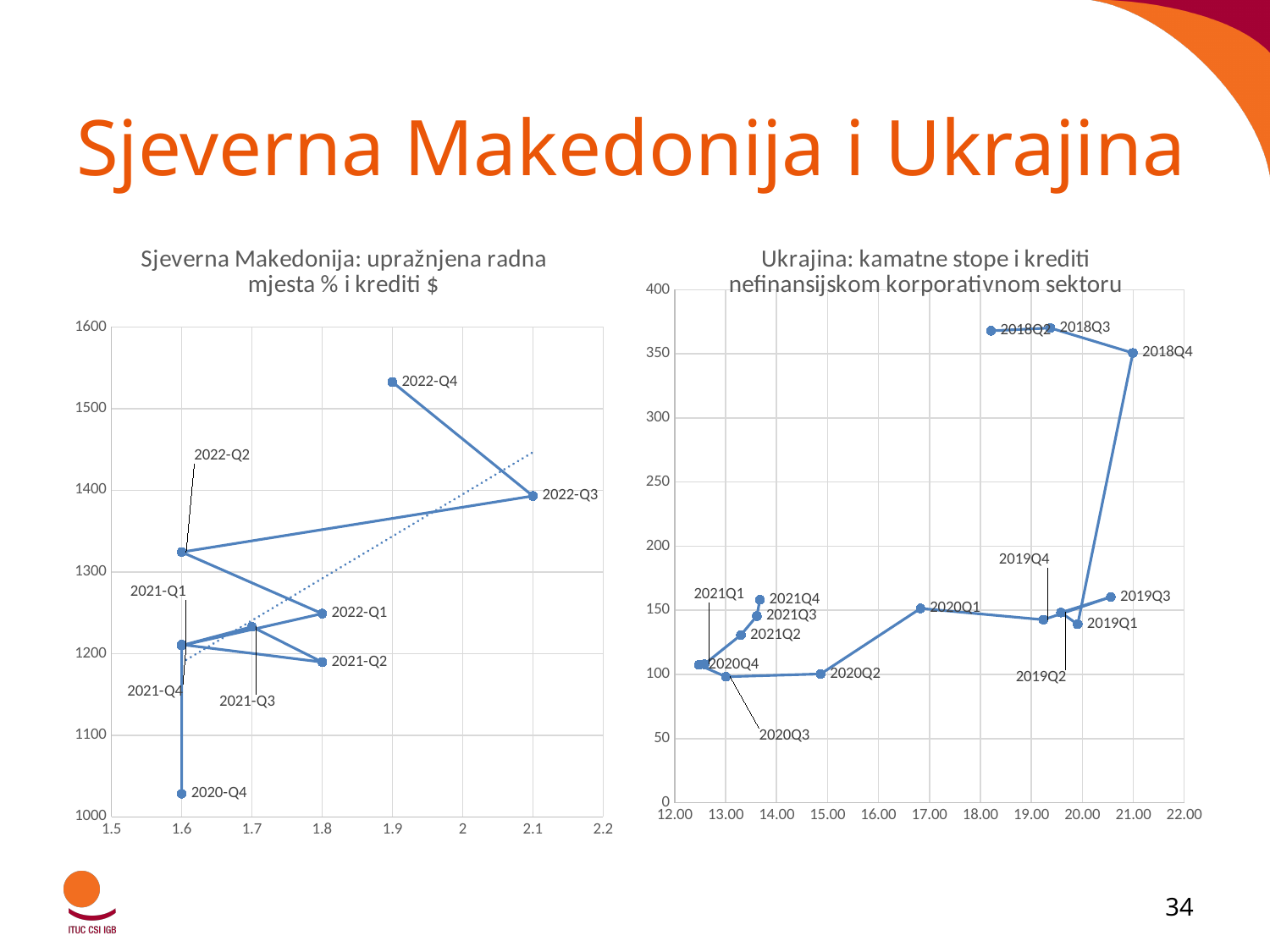
What is the title of the left chart? Sjeverna Makedonija: upražnjena radna mjesta % i krediti $ In the right chart (Ukrajina), is the vertical-axis value for 2020Q2 greater or less than 150? less In the left chart (Sjeverna Makedonija), which labelled point has the highest vertical-axis value? 2022-Q4 In the left chart (Sjeverna Makedonija), is the vertical-axis value for 2020-Q4 greater or less than 1100? less In the left chart (Sjeverna Makedonija), which labelled point lies furthest to the right on the horizontal axis? 2022-Q3 How many labelled data points are plotted in the left chart (Sjeverna Makedonija)? 9 In the right chart (Ukrajina), is the vertical-axis value for 2018Q4 larger than that for 2019Q1? Yes, 2018Q4 What kind of chart is the right chart (Ukrajina)? Scatter chart with connected points In the right chart (Ukrajina), which labelled point lies furthest to the right on the horizontal axis? 2018Q4 In the left chart (Sjeverna Makedonija), is the vertical-axis value for 2022-Q4 greater or less than 1500? greater In the left chart (Sjeverna Makedonija), which labelled point has the lowest vertical-axis value? 2020-Q4